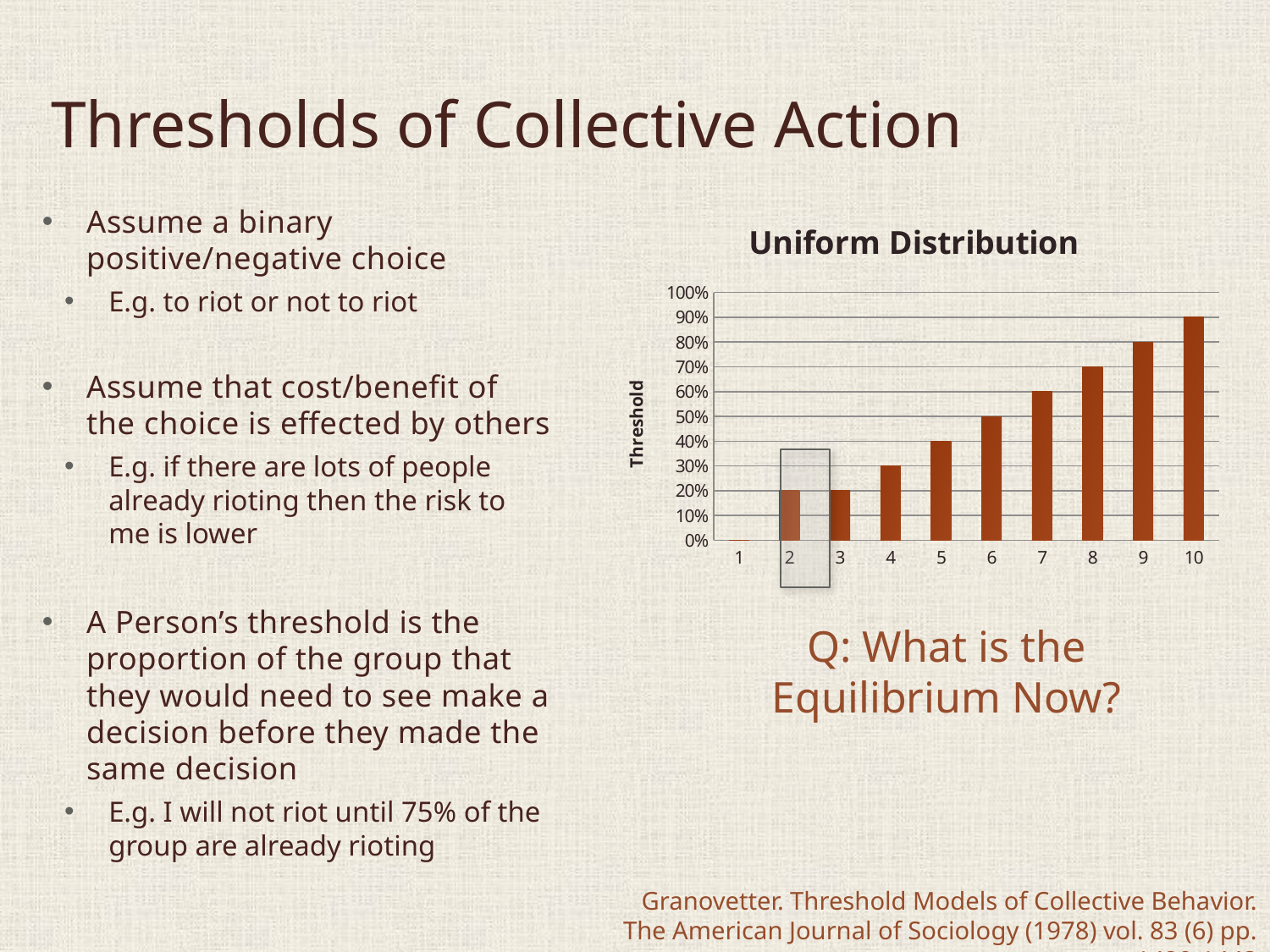
What type of chart is shown under the title "Uniform Distribution"? Bar chart Which category has the highest threshold value? 10 Do the threshold values generally rise or fall from category 2 to category 10? Rise Which category has the lowest threshold value? 1 Which has a larger threshold value, category 5 or category 7? Category 7 How many categories are shown along the x axis of the chart? 10 What is the title of the chart on the slide? Uniform Distribution What is the label on the vertical axis of the chart? Threshold What is the threshold value for category 10? 90% What is the difference between the threshold values for category 8 and category 4? 40% What is the threshold value for category 2? 20% What is the threshold value for category 6? 50%